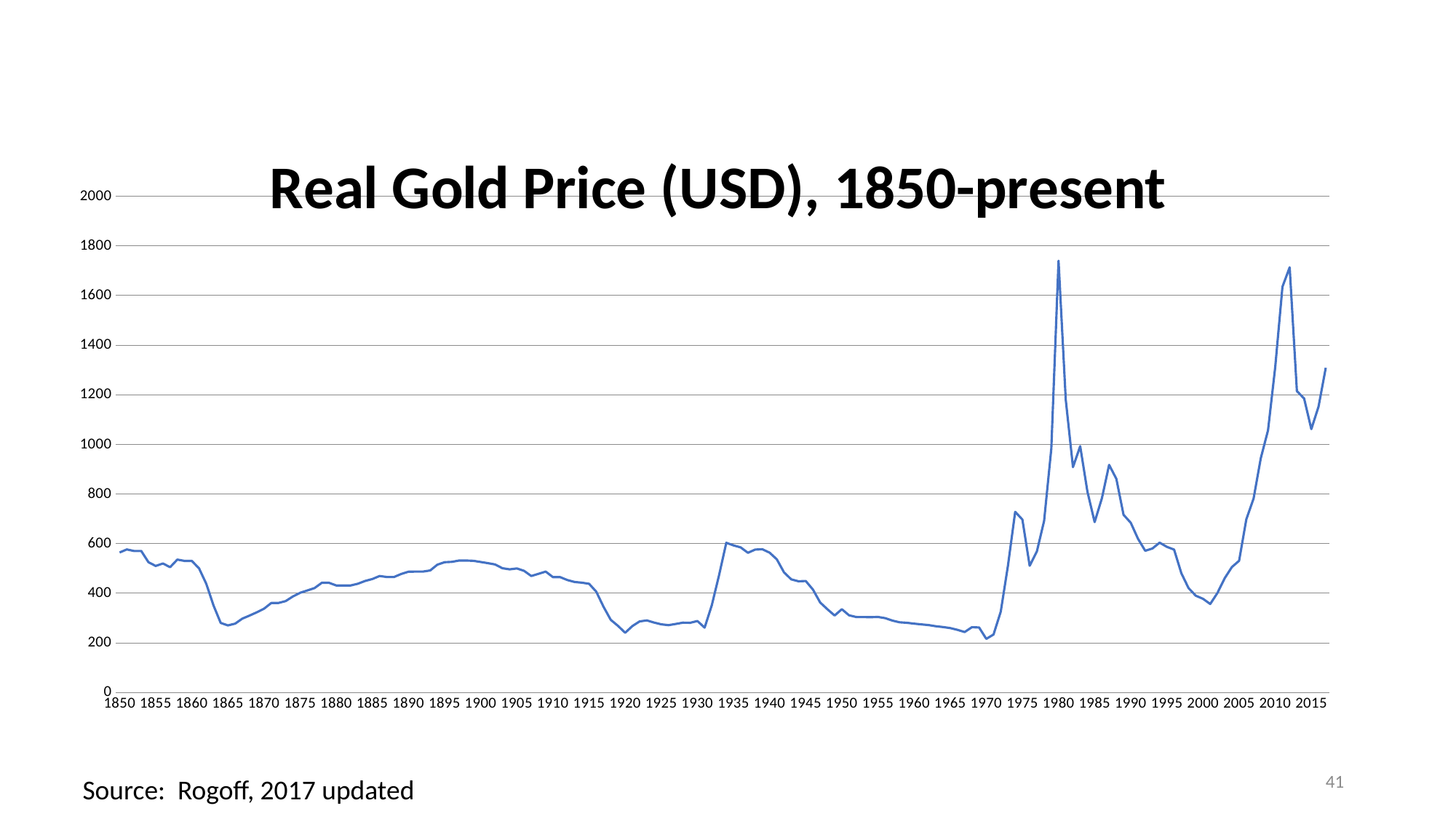
Is the value for 1865 greater or less than 400? less What kind of chart is shown on the slide? line chart Is the value for 2015 greater or less than 1000? greater Does the real gold price rise or fall between 2000 and 2010? rise What is the title of the chart? Real Gold Price (USD), 1850-present What colour is the line plotted on the chart? blue Is the value for 1850 greater or less than 400? greater Does the real gold price rise or fall between 1980 and 2000? fall Which is larger, the value for 1980 or the value for 1935? 1980